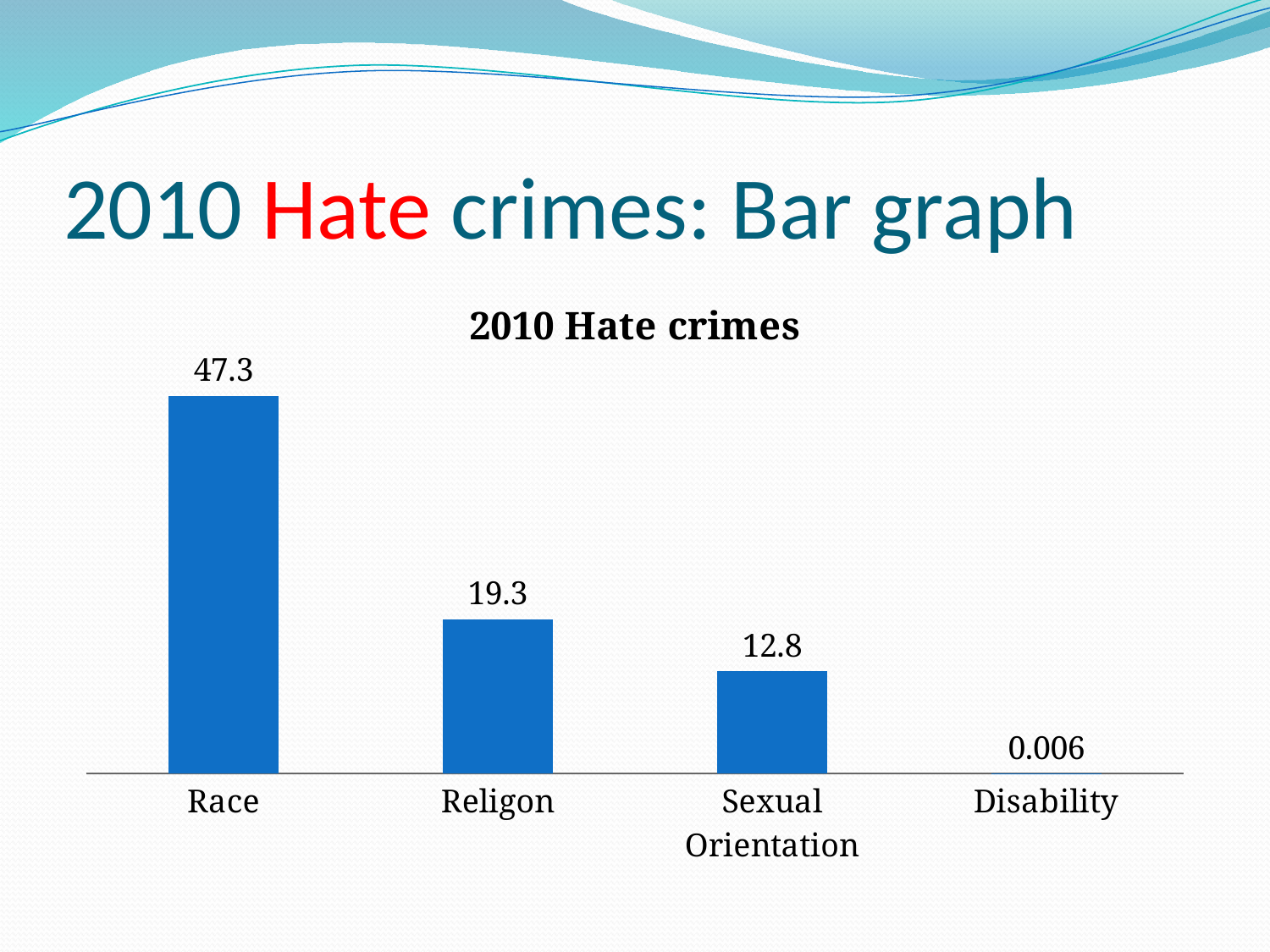
What is the value for Race? 47.3 Which is larger, the value for Religon or the value for Sexual Orientation? Religon What is the title of the chart? 2010 Hate crimes Which category has the lowest value? Disability What is the value for Disability? 0.006 What is the value for Religon? 19.3 What is the difference between the values for Religon and Sexual Orientation? 6.5 How many categories are shown in the chart? 4 What is the value for Sexual Orientation? 12.8 Which category has the highest value? Race What kind of chart is shown on the slide? Bar chart What is the difference between the values for Race and Religon? 28